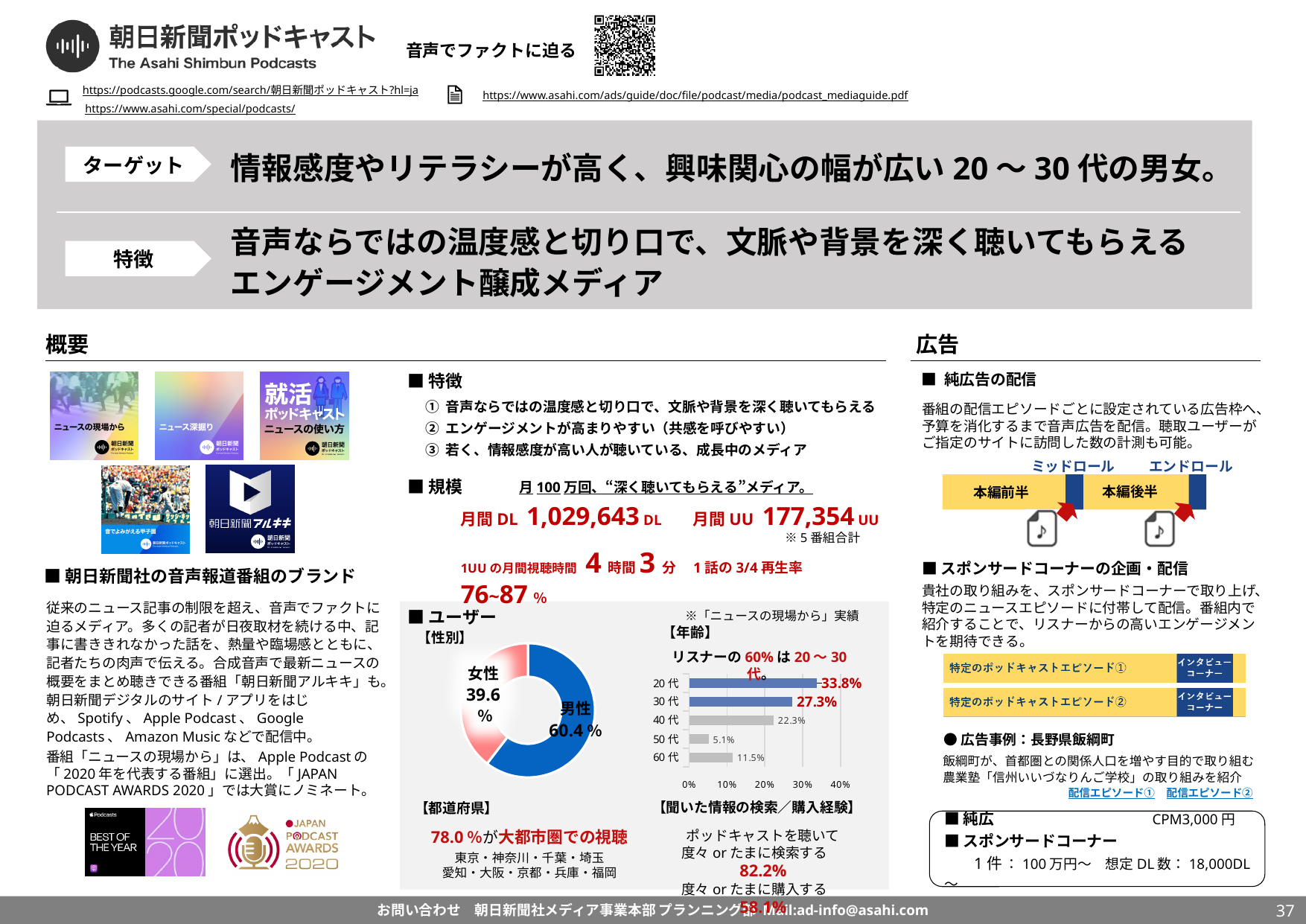
In the 【年齢】 bar chart, which age group has the lowest value? 50 代 In the 【年齢】 bar chart, which is larger, the value for 40 代 or 60 代? 40 代 What kind of chart is the 【性別】 chart? donut chart In the 【性別】 chart, what is the share for 男性? 60.4% In the 【年齢】 bar chart, what is the value for 40 代? 22.3% In the 【年齢】 bar chart, is the value for 30 代 greater or less than 20%? greater In the 【年齢】 bar chart, which age group has the highest value? 20 代 In the 【年齢】 bar chart, what is the difference between the values for 20 代 and 30 代? 6.5% What kind of chart is the 【年齢】 chart? bar chart In the 【年齢】 bar chart, what is the value for 20 代? 33.8% In the 【性別】 chart, what is the share for 女性? 39.6% How many age groups are shown in the 【年齢】 bar chart? 5